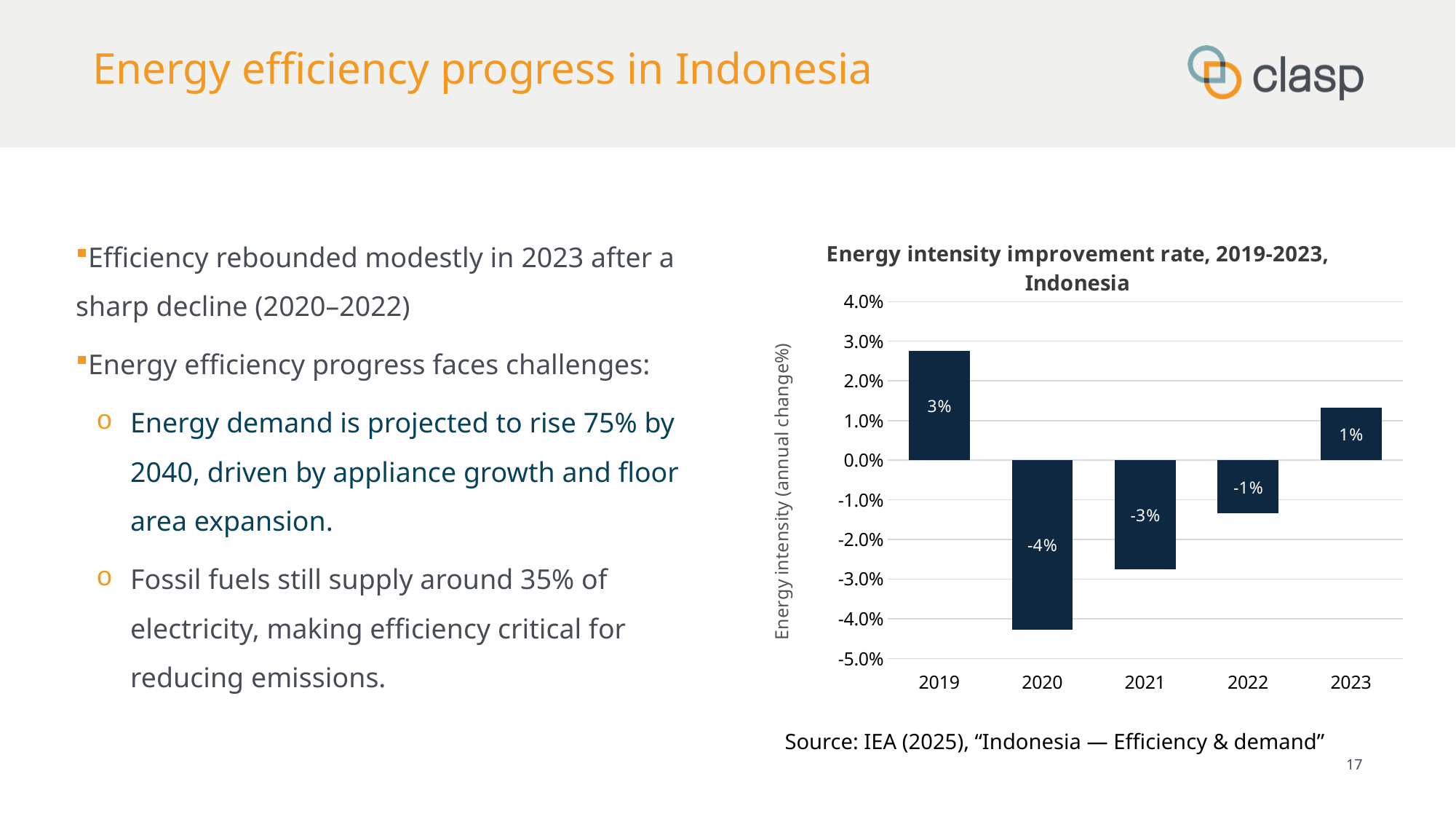
Which year has the lowest energy intensity improvement rate? 2020 What type of chart is shown on the slide? Bar chart What is the data label shown for 2019? 3% Which year has the highest energy intensity improvement rate? 2019 What is the title of the chart? Energy intensity improvement rate, 2019-2023, Indonesia What is the data label shown for 2020? -4% What is the data label shown for 2023? 1% What is the label on the vertical axis of the chart? Energy intensity (annual change%) How many years are shown on the x axis of the chart? 5 Which year has the lower value, 2021 or 2022? 2021 What is the data label shown for 2022? -1%